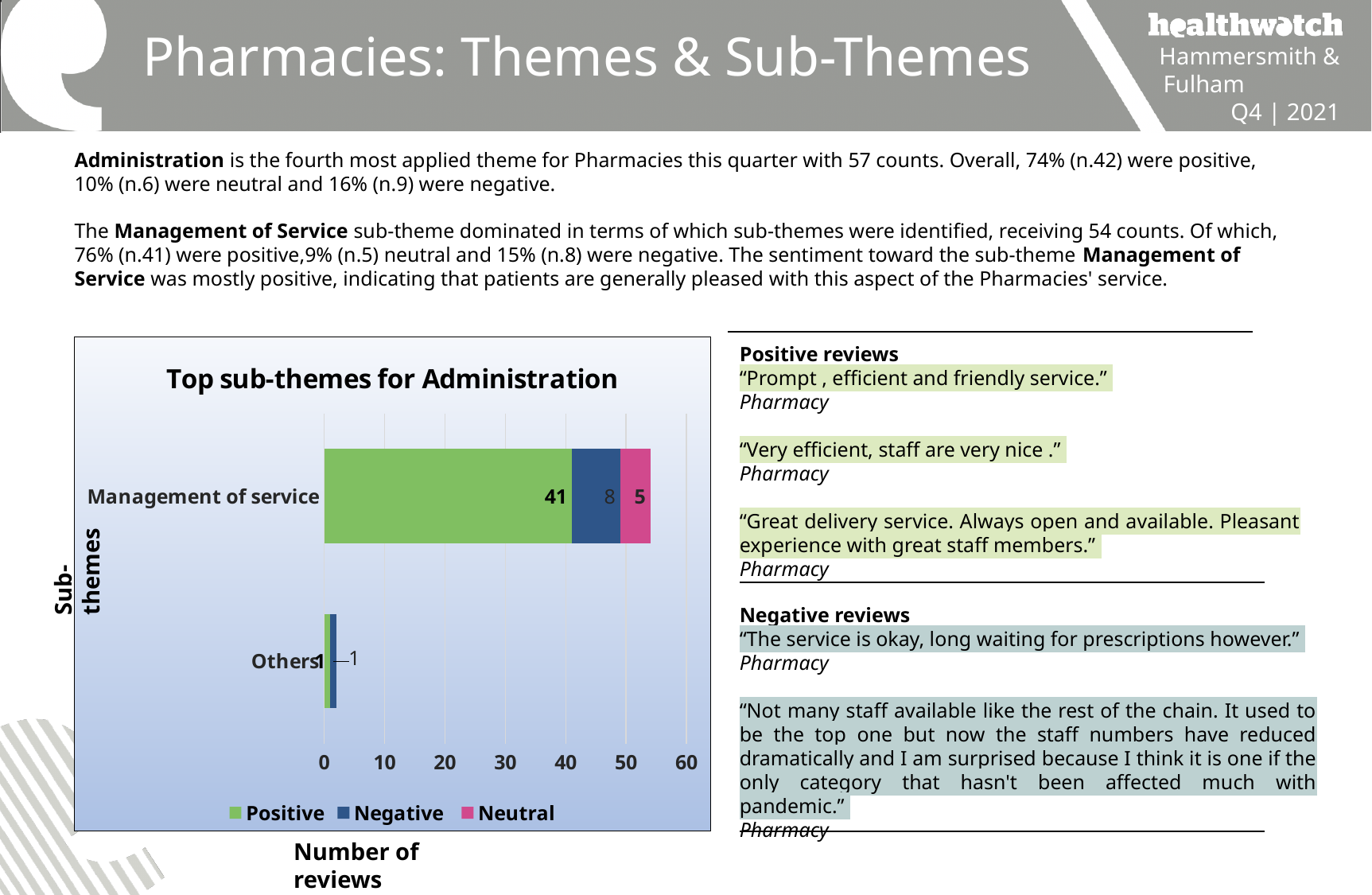
What is the Neutral value for Management of service? 5 What is the Positive value for Others? 1 Is the Positive value for Management of service greater or less than 40? greater What is the Negative value for Management of service? 8 How many series does the chart legend list? 3 What is the difference between the Positive and Negative values for Management of service? 33 Which sub-theme has the highest number of Positive reviews? Management of service How many sub-theme categories are plotted in the chart? 2 What is the Positive value for Management of service? 41 What is the title of the chart? Top sub-themes for Administration What kind of chart is shown on the slide? Bar chart What is the total number of reviews in the Management of service bar? 54